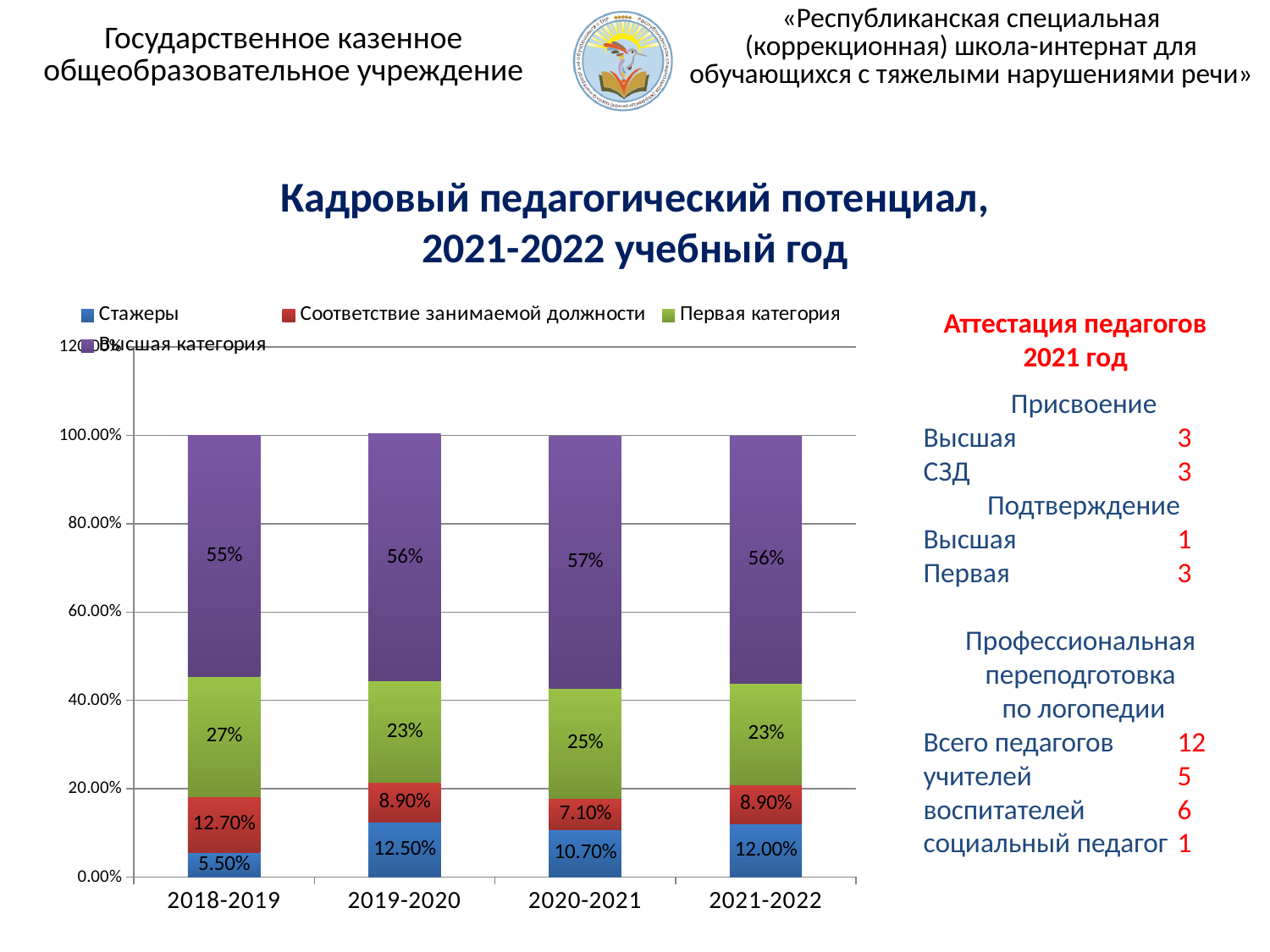
In which year is the Стажеры share lowest? 2018-2019 What kind of chart is shown on the slide? Stacked bar chart In which year is the Высшая категория share highest? 2020-2021 What is the difference between the Высшая категория values for 2020-2021 and 2018-2019? 2% What is the value for Стажеры in 2018-2019? 5.50% How many series does the legend list? 4 Which year has the larger Первая категория share, 2018-2019 or 2020-2021? 2018-2019 What is the difference between the Стажеры values for 2019-2020 and 2018-2019? 7.00% What is the value for Соответствие занимаемой должности in 2020-2021? 7.10% How many academic years are shown on the x axis? 4 What is the value for Первая категория in 2021-2022? 23% What is the value for Высшая категория in 2019-2020? 56%